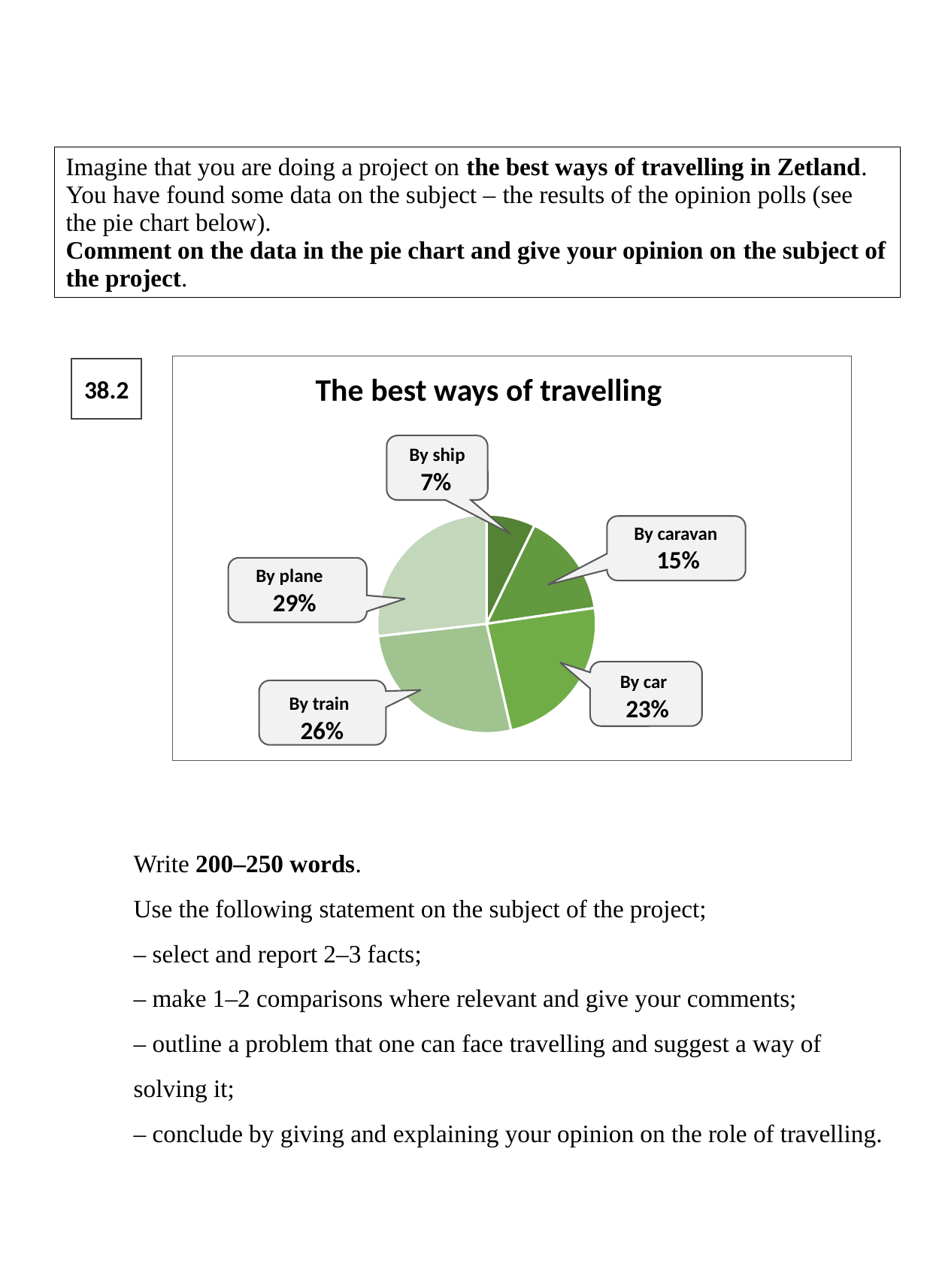
What percentage of respondents chose travelling by plane? 29% What type of chart is shown on the slide? Pie chart What is the value shown for travelling by ship? 7% What is the combined share of travelling by train and by car? 49% How many ways of travelling are shown in the pie chart? 5 What is the difference in percentage points between travelling by car and travelling by ship? 16 What is the title of the chart? The best ways of travelling What share is shown for travelling by caravan? 15% Which way of travelling has the smallest share in the pie chart? By ship Which has a larger share: travelling by car or travelling by caravan? By car What is the difference in percentage points between travelling by plane and travelling by train? 3 Which way of travelling has the largest share in the pie chart? By plane